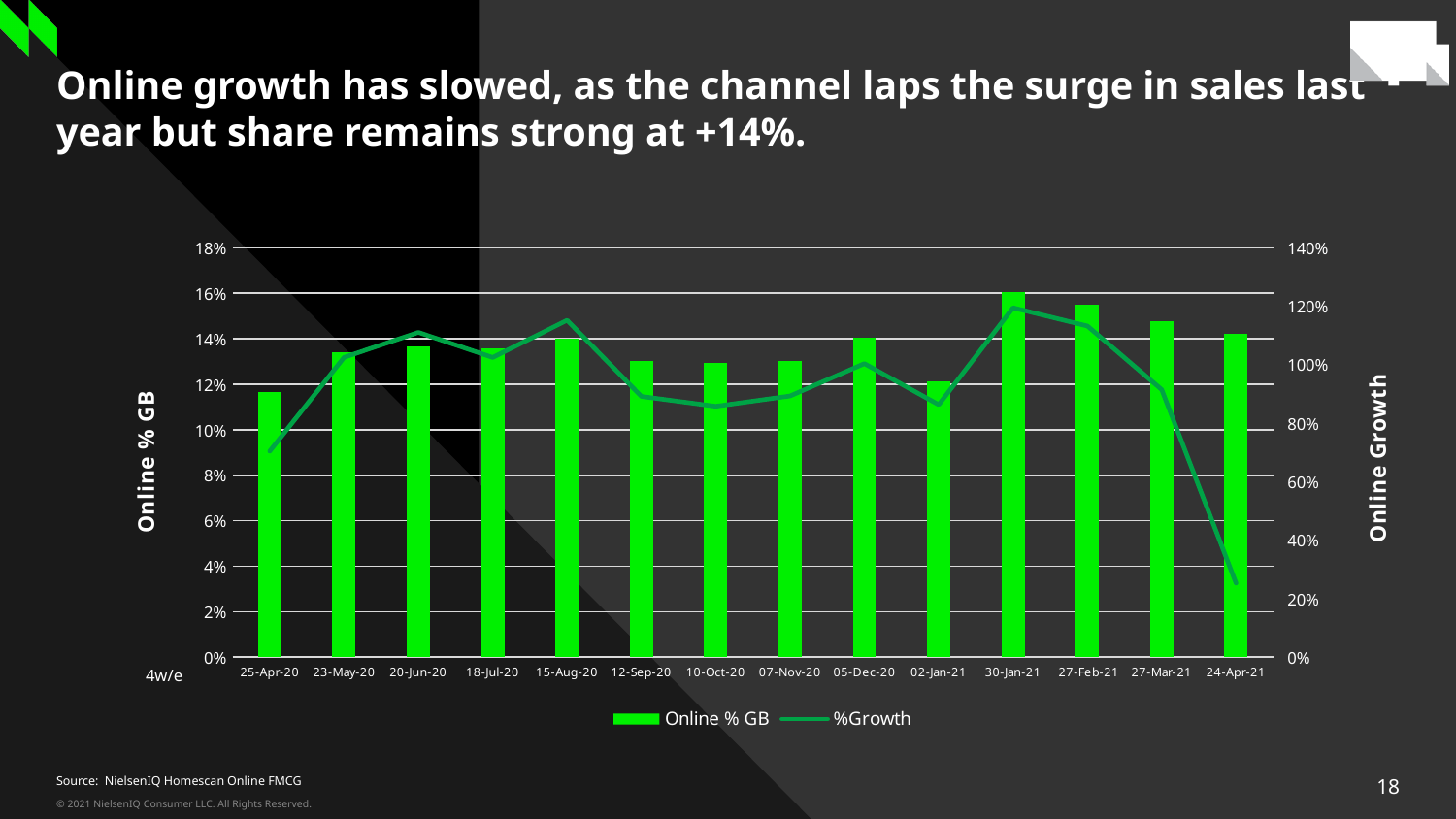
Which period has the lowest Online % GB bar? 25-Apr-20 Is the %Growth value for 24-Apr-21 greater or less than 40%? less Does the %Growth line rise or fall between 27-Feb-21 and 24-Apr-21? It falls Which period has the lowest %Growth value on the line? 24-Apr-21 What kind of chart is shown on the slide? A combination bar and line chart How many series does the legend list? 2 Which period has the highest Online % GB bar? 30-Jan-21 What is the title of the right-hand vertical axis? Online Growth How many dates (4w/e periods) are shown on the x axis? 14 Is the Online % GB value for 30-Jan-21 greater or less than 14%? greater Which has the larger Online % GB bar, 15-Aug-20 or 02-Jan-21? 15-Aug-20 Is the Online % GB value for 25-Apr-20 greater or less than 12%? less